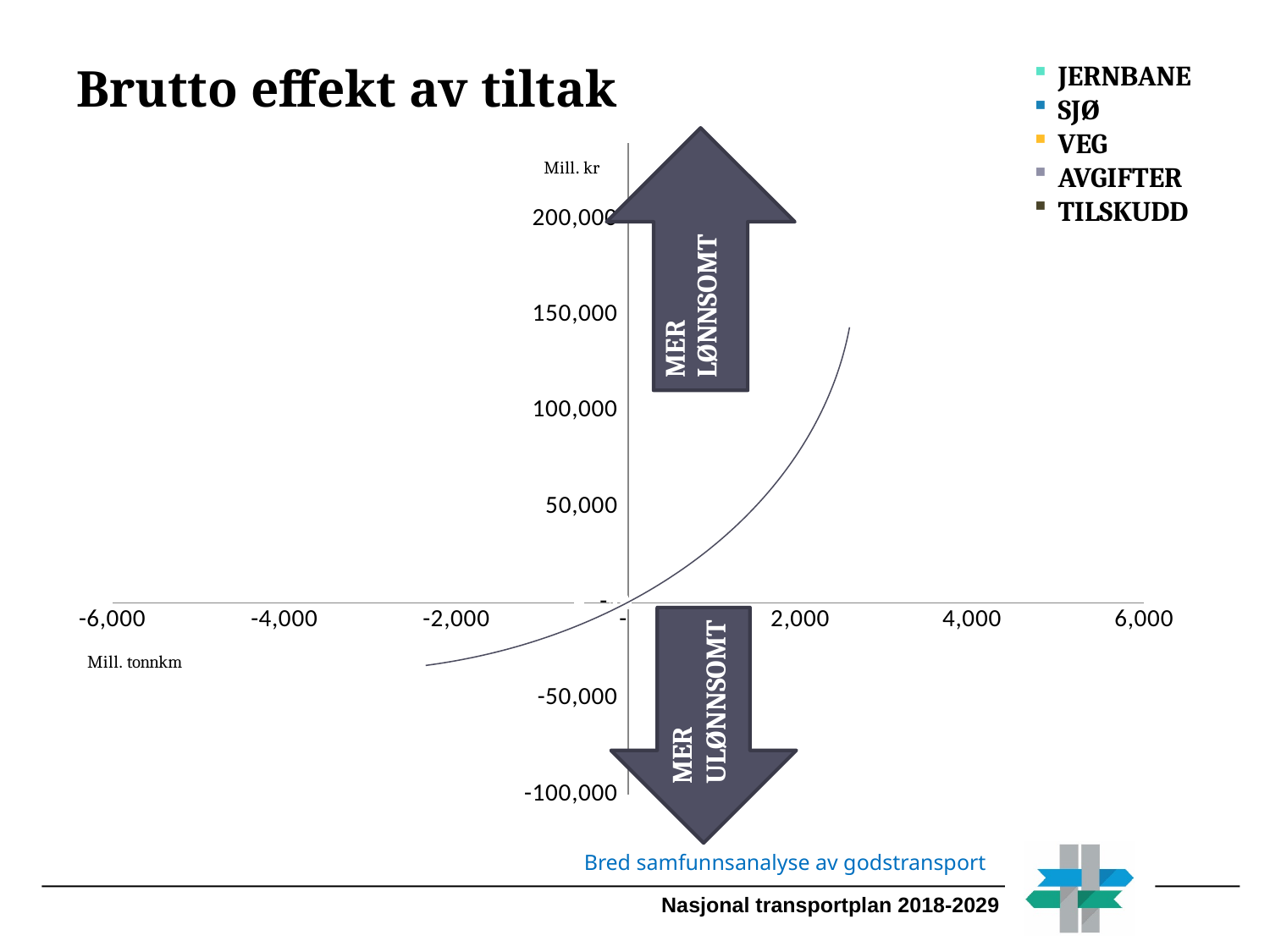
What is the title of the chart on the slide? Brutto effekt av tiltak How many series does the chart's legend list? 5 What is the highest value labelled on the vertical axis of the chart? 200,000 What unit is shown on the vertical axis of the chart? Mill. kr Does the curve plotted on the chart rise or fall as it moves from left to right along the x axis? rise